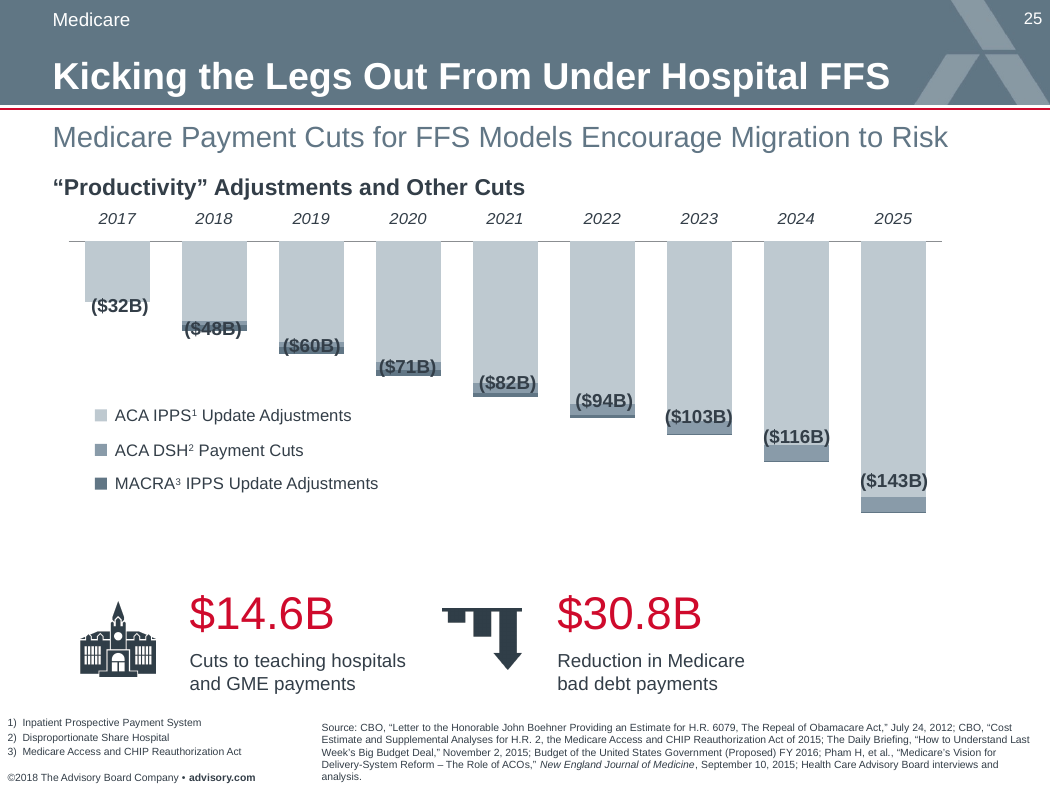
What is the difference between the total cuts labeled for 2025 and 2024? $27B What is the total value labeled for 2017 in the "Productivity" Adjustments and Other Cuts chart? ($32B) How many series does the chart's legend list? 3 What is the total value labeled for 2021 in the chart? ($82B) What kind of chart is used to show the "Productivity" Adjustments and Other Cuts? Stacked bar chart What is the total value labeled for 2025 in the chart? ($143B) Which year has the largest total cut shown in the chart? 2025 Which year shows a larger total cut, 2020 or 2022? 2022 Do the total cuts increase or decrease from 2017 to 2025? Increase What is the difference between the total cuts labeled for 2018 and 2017? $16B How many years are shown on the x axis of the chart? 9 Which year has the smallest total cut shown in the chart? 2017